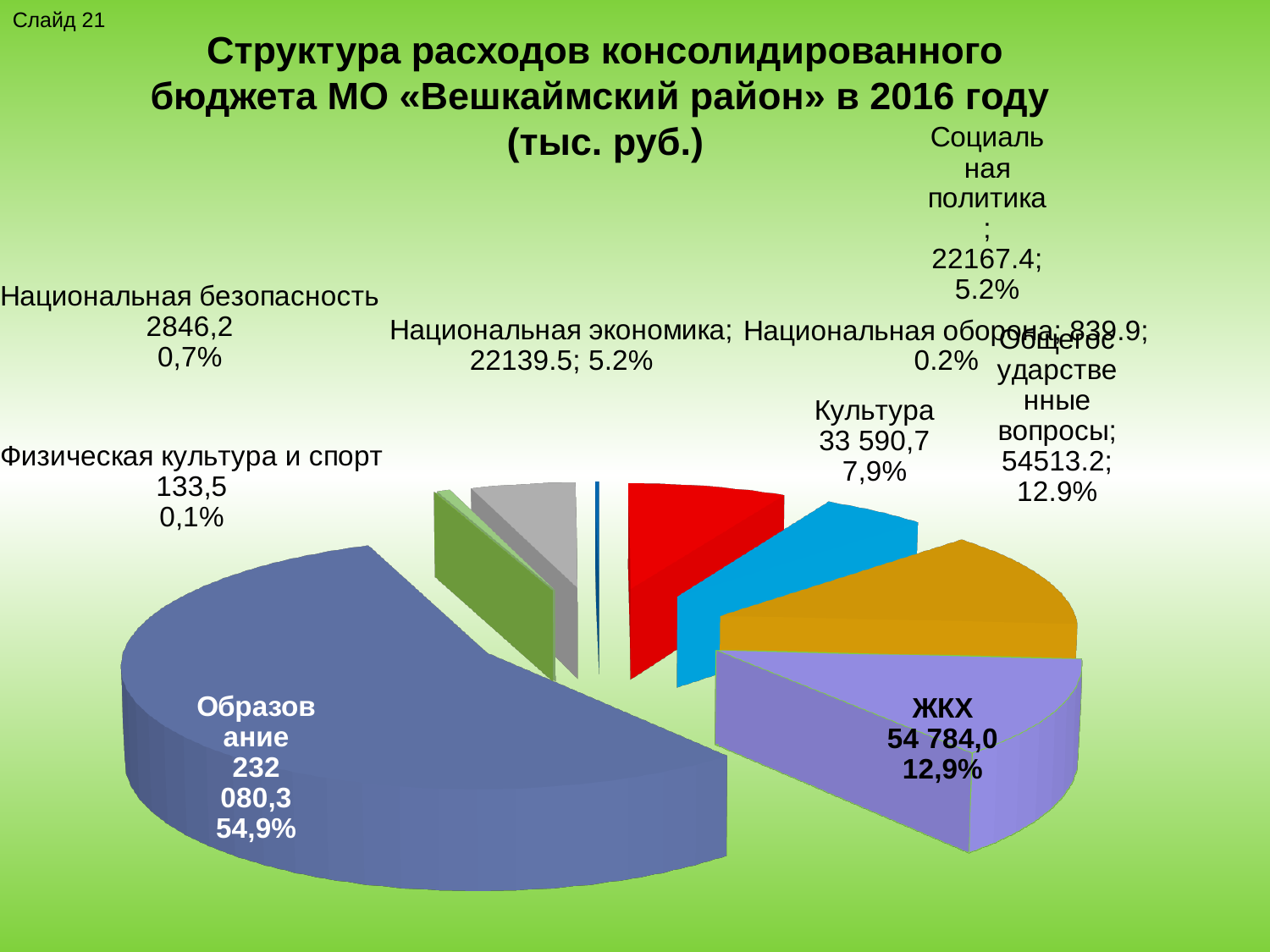
How many categories are shown in the pie chart? 9 What value is shown for ЖКХ? 54 784,0 What value is shown for Образование? 232 080,3 Which category has the largest share of the pie? Образование What is the difference between the values for Национальная безопасность and Физическая культура и спорт? 2712,7 What kind of chart is shown on the slide? Pie chart Which category has the smallest share of the pie? Физическая культура и спорт What value is shown for Национальная оборона? 839.9 What share of the pie does Культура take? 7,9% Which is larger, the value for Культура or the value for Национальная экономика? Культура What value is shown for Социальная политика? 22167.4 What share of the pie does Образование take? 54,9%